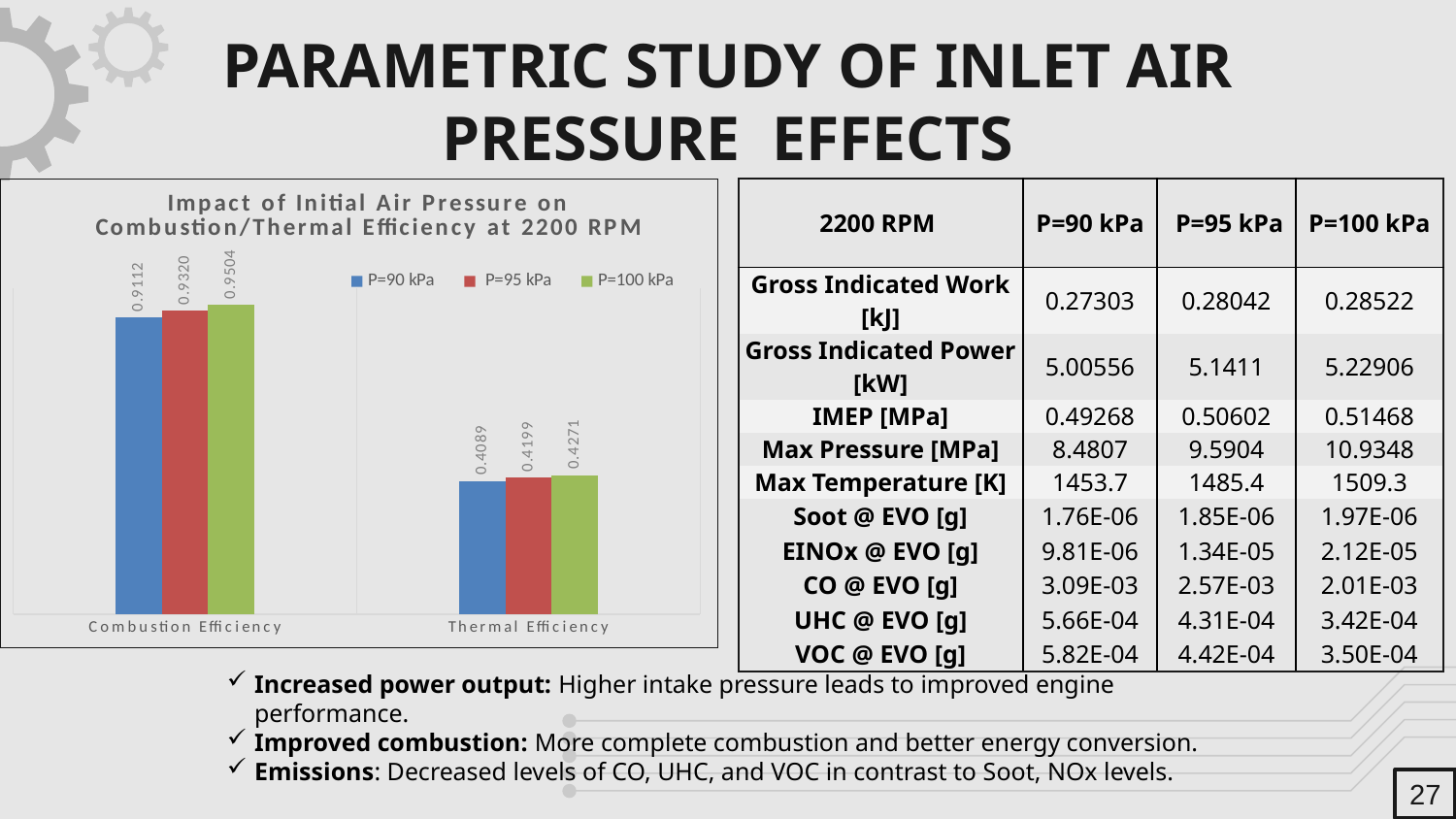
What is the combustion efficiency at P=95 kPa? 0.9320 Which pressure series gives the highest combustion efficiency? P=100 kPa What is the combustion efficiency at P=90 kPa? 0.9112 What is the difference between the thermal efficiency at P=95 kPa and at P=90 kPa? 0.0110 How many categories are shown on the x axis of the chart? 2 What is the thermal efficiency at P=90 kPa? 0.4089 Which pressure series gives the lowest thermal efficiency? P=90 kPa How many series does the chart legend list? 3 What type of chart is shown on the slide? Bar chart Which is larger: the combustion efficiency at P=95 kPa or the thermal efficiency at P=100 kPa? Combustion efficiency at P=95 kPa What is the thermal efficiency at P=100 kPa? 0.4271 What is the difference between the combustion efficiency at P=100 kPa and at P=90 kPa? 0.0392